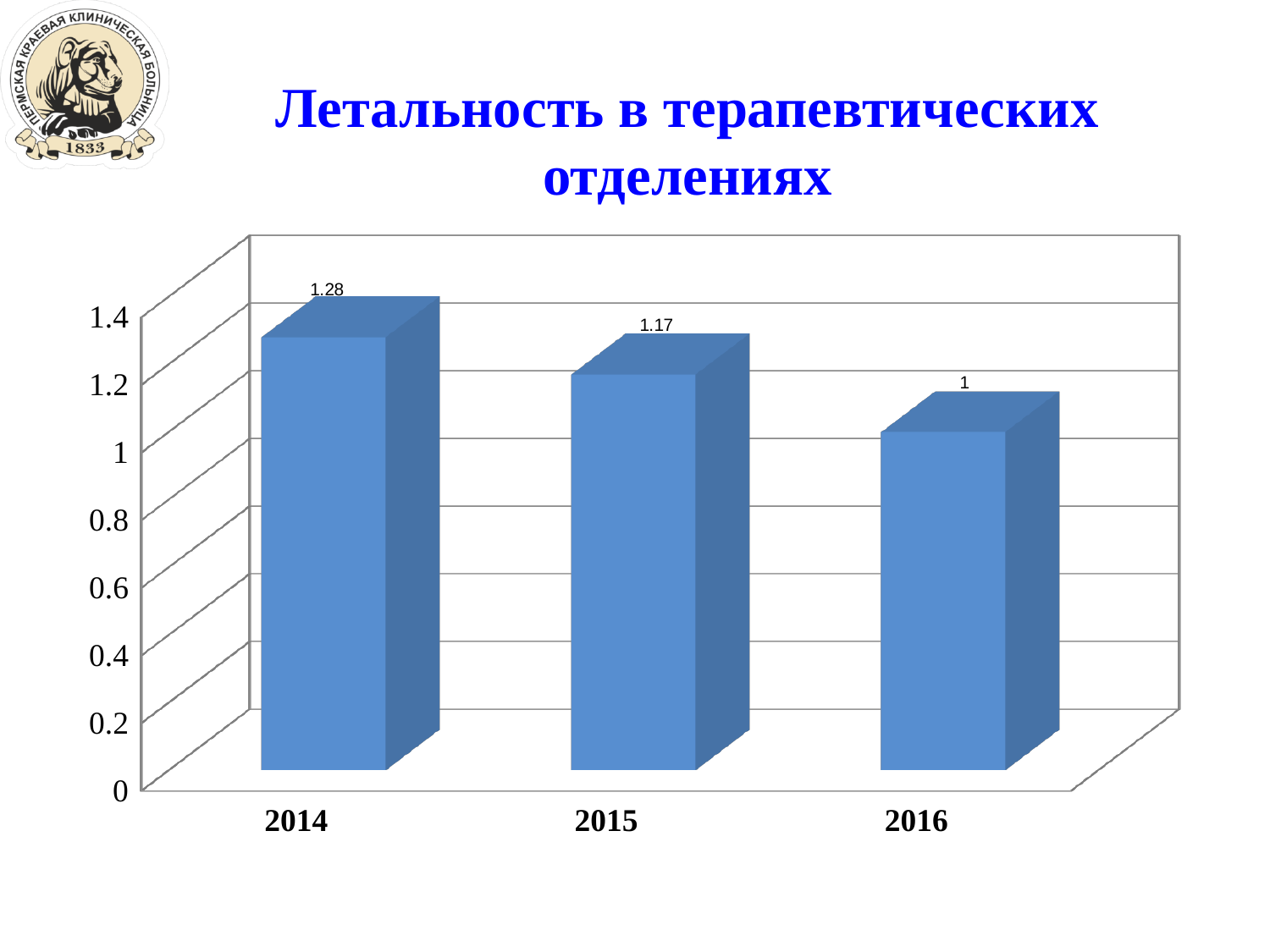
What is the value for 2014? 1.28 What kind of chart is shown on the slide? bar chart What is the value for 2015? 1.17 Which is larger, the value for 2015 or the value for 2016? 2015 What is the value for 2016? 1 What is the difference between the values for 2014 and 2016? 0.28 How many years are shown on the chart? 3 Which year has the lowest value? 2016 What is the difference between the values for 2014 and 2015? 0.11 Do the values rise or fall from 2014 to 2016? fall Which year has the highest value? 2014 Is the value for 2015 greater or less than 1.2? less